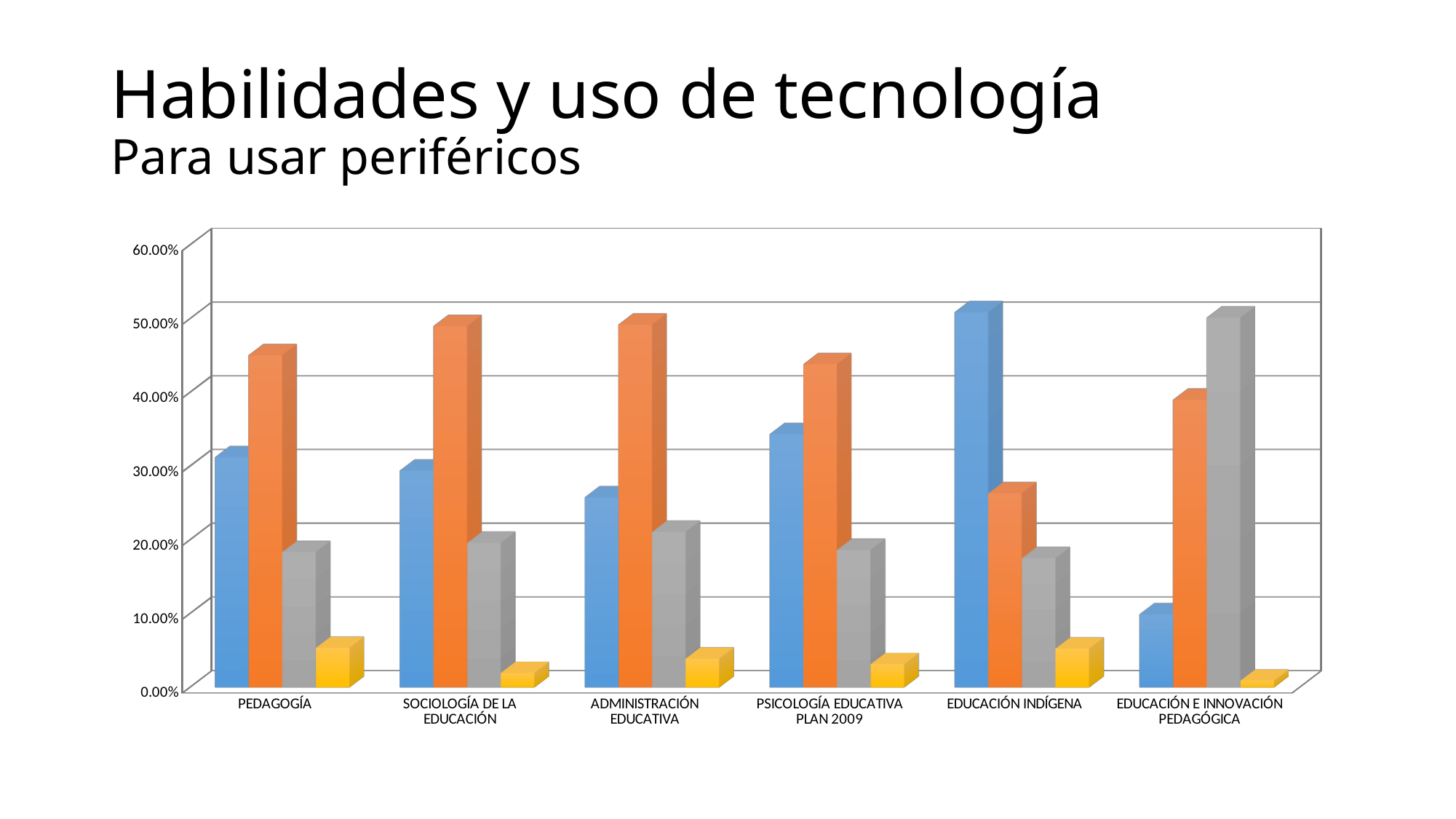
How many categories are shown along the x axis of the chart? 6 What kind of chart is shown on the slide? bar chart For EDUCACIÓN INDÍGENA, which is larger: the blue bar or the orange bar? the blue bar Is the gray bar for EDUCACIÓN E INNOVACIÓN PEDAGÓGICA greater or less than 40.00%? greater Is the blue bar for EDUCACIÓN E INNOVACIÓN PEDAGÓGICA greater or less than 20.00%? less Is the yellow bar for PEDAGOGÍA greater or less than 10.00%? less For PEDAGOGÍA, which is larger: the blue bar or the orange bar? the orange bar Which category has the lowest orange bar? EDUCACIÓN INDÍGENA How many bars are plotted for each category in the chart? 4 Which category has the highest blue bar? EDUCACIÓN INDÍGENA